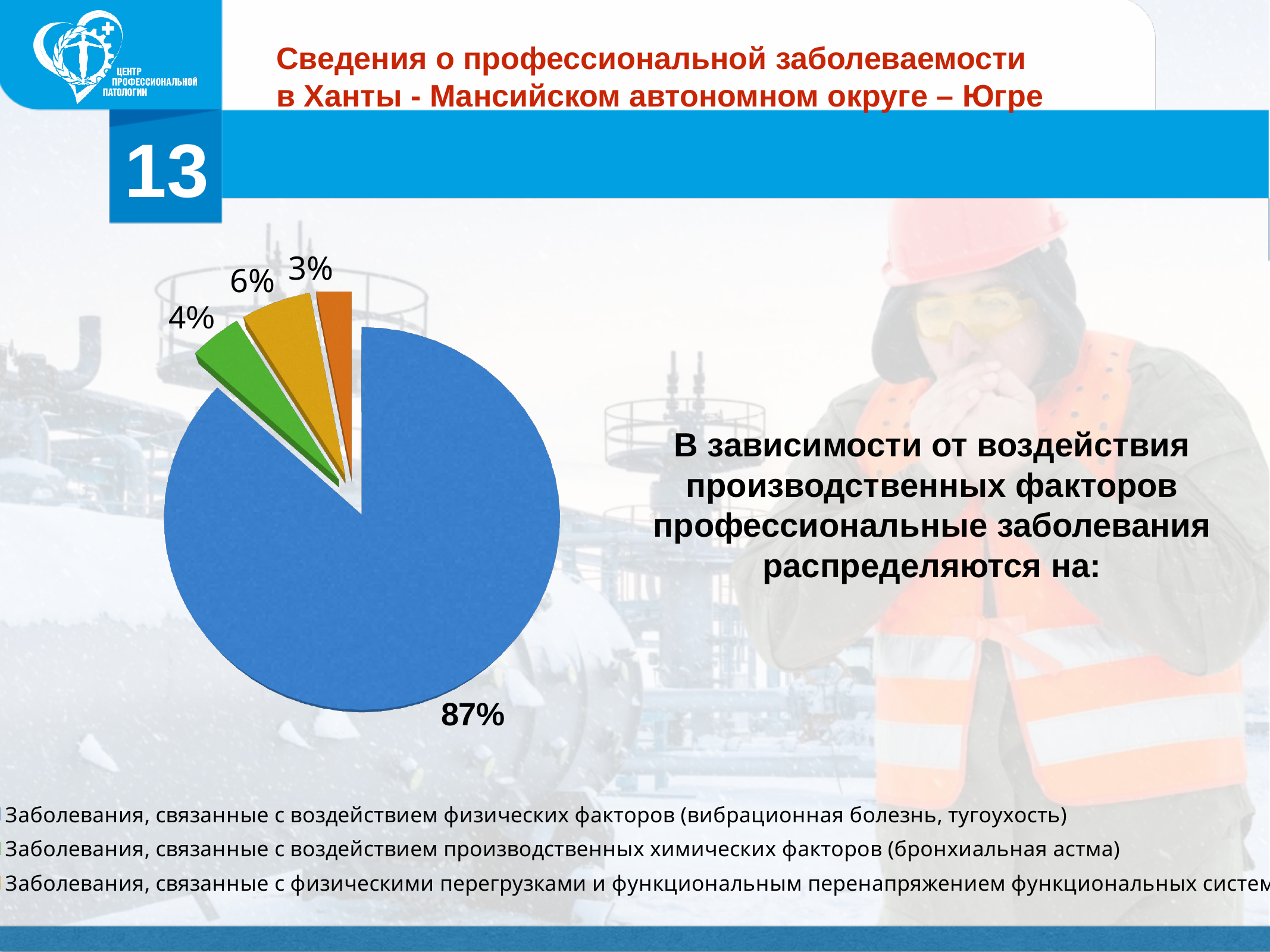
What is the value of the smallest slice of the pie chart? 3% What value is labelled on the green slice of the pie chart? 4% By how many percentage points does the blue slice exceed the green slice? 83 What value is labelled on the yellow slice of the pie chart? 6% How many slices does the pie chart have? 4 What kind of chart is shown on the slide? pie chart What value is labelled on the blue slice of the pie chart? 87% By how many percentage points does the yellow slice exceed the orange slice? 3 What value is labelled on the orange slice of the pie chart? 3% Which slice is larger, the green one or the orange one? the green one What colour is the largest slice of the pie chart? blue What is the value of the largest slice of the pie chart? 87%